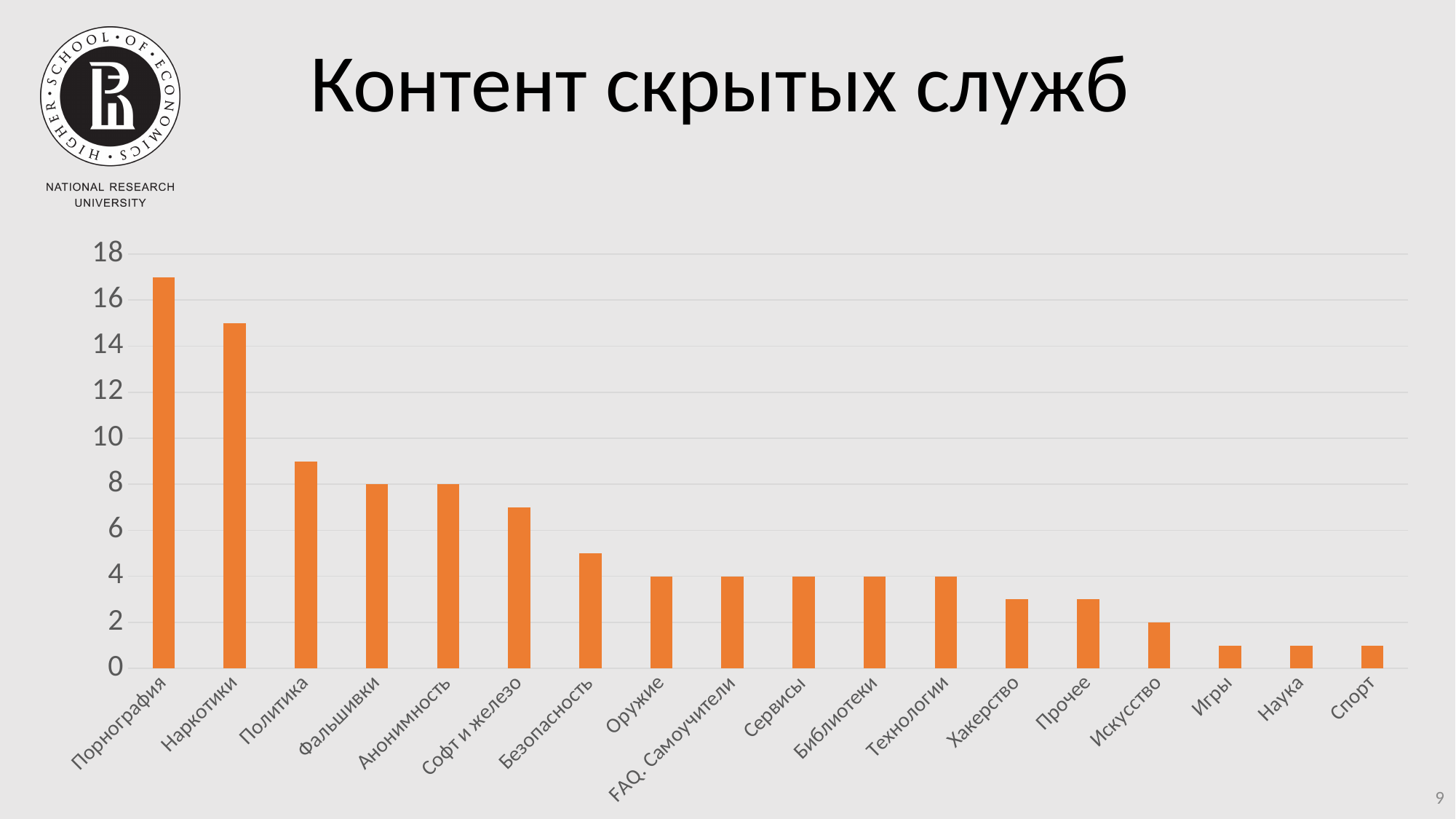
Is the value for Спорт greater or less than 2? less What kind of chart is shown on the slide? bar chart Do the values rise or fall from left to right along the x axis? fall What is the value for Искусство? 2 What is the difference between the values for Анонимность and Библиотеки? 4 Which category has the highest value in the chart? Порнография Is the value for Порнография greater or less than 16? greater What is the value for Фальшивки? 8 Is the value for Безопасность greater or less than 6? less How many categories are shown on the x axis of the chart? 18 What is the value for Оружие? 4 Which is larger, the value for Наркотики or the value for Политика? Наркотики